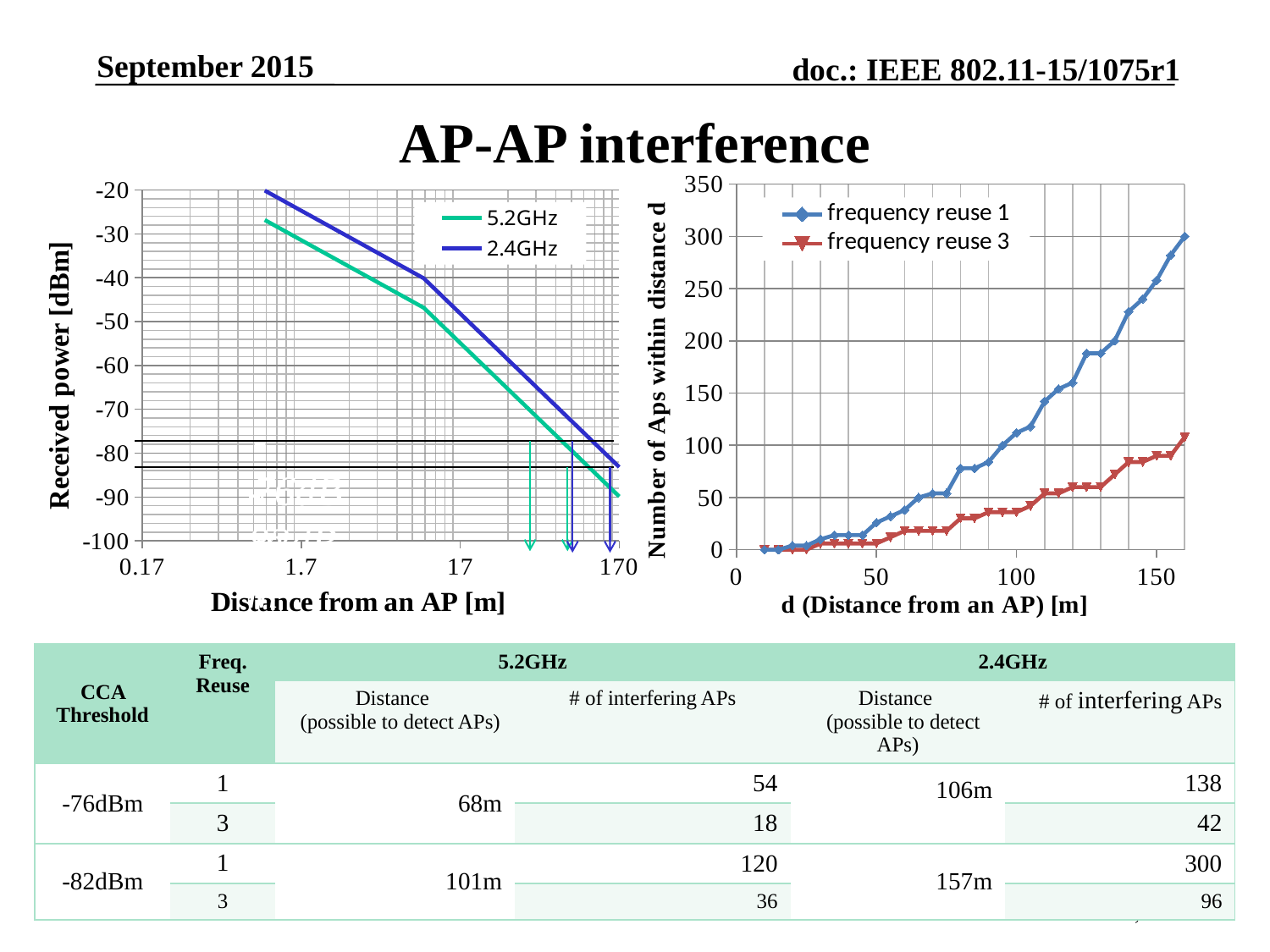
What kind of chart is the left chart (Received power vs Distance from an AP)? line chart In the left chart, which series has the higher received power at a distance of 17 m, 5.2GHz or 2.4GHz? 2.4GHz How many series does the legend of the left chart list? 2 How many series does the legend of the right chart (Number of APs within distance d) list? 2 In the left chart, does the received power rise or fall as the distance from an AP increases? fall What is the y-axis label of the left chart? Received power [dBm] In the right chart, which series has more APs at d = 150 m, frequency reuse 1 or frequency reuse 3? frequency reuse 1 In the right chart, is the value for frequency reuse 3 at d = 100 m greater or less than 50? less In the right chart, is the value for frequency reuse 1 at d = 130 m greater or less than 150? greater In the right chart, does the number of APs rise or fall as d increases? rise In the left chart, is the received power for 2.4GHz at 17 m greater or less than -50 dBm? greater